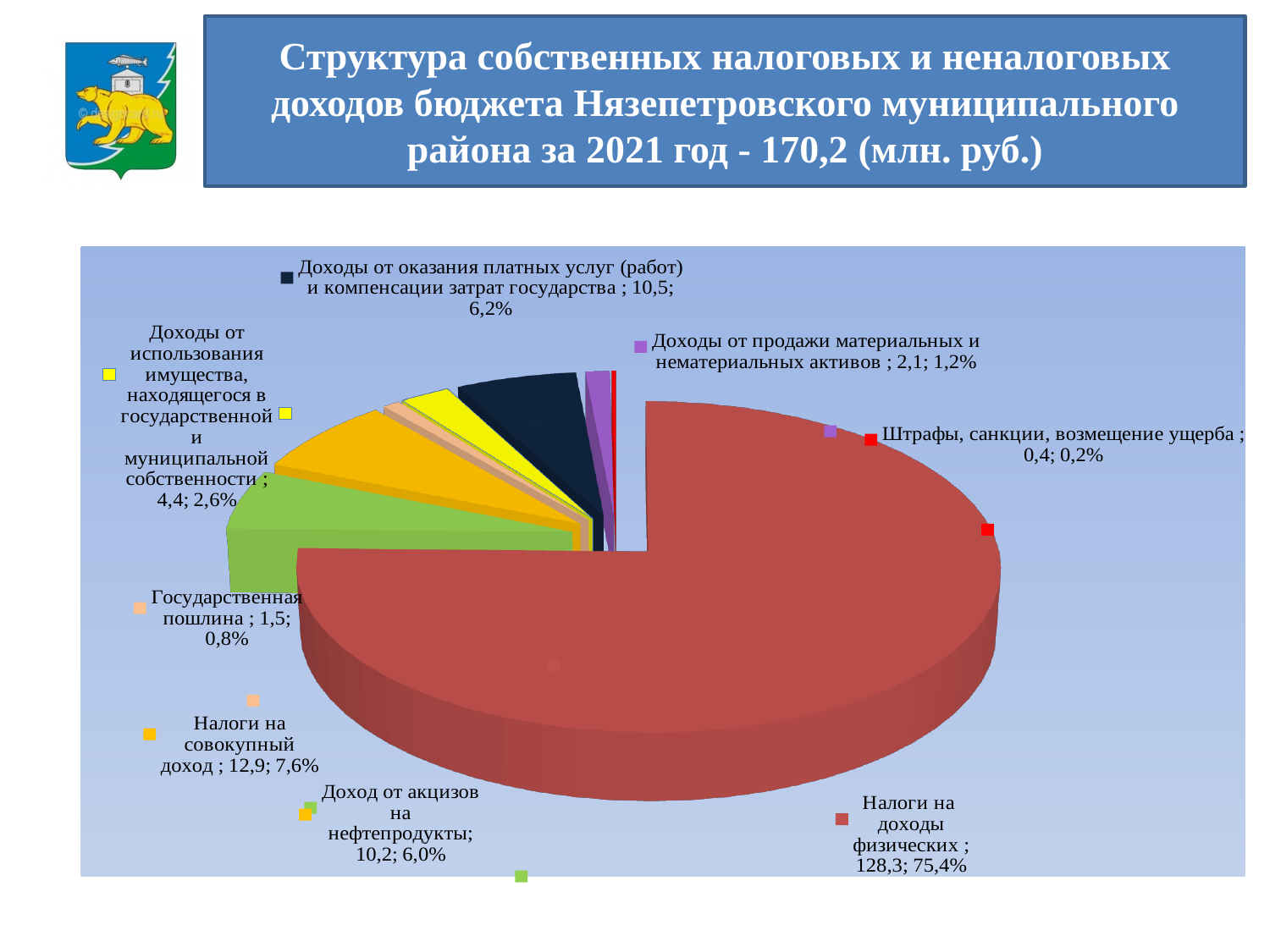
What share of the pie does Государственная пошлина represent? 0,8% What is the value for Доход от акцизов на нефтепродукты? 10,2 What is the value (млн. руб.) for Налоги на доходы физических лиц? 128,3 Which is larger: the value for Доходы от оказания платных услуг (работ) и компенсации затрат государства or the value for Доходы от использования имущества? Доходы от оказания платных услуг (работ) и компенсации затрат государства What share of the pie does Налоги на совокупный доход represent? 7,6% What type of chart is shown on the slide? pie chart What share of the pie does Доходы от продажи материальных и нематериальных активов represent? 1,2% What total amount (млн. руб.) is stated in the chart title for 2021? 170,2 How many categories (slices) does the pie chart have? 8 What is the difference between the values for Налоги на совокупный доход and Доход от акцизов на нефтепродукты? 2,7 Which category has the largest slice of the pie? Налоги на доходы физических Which category has the smallest slice of the pie? Штрафы, санкции, возмещение ущерба